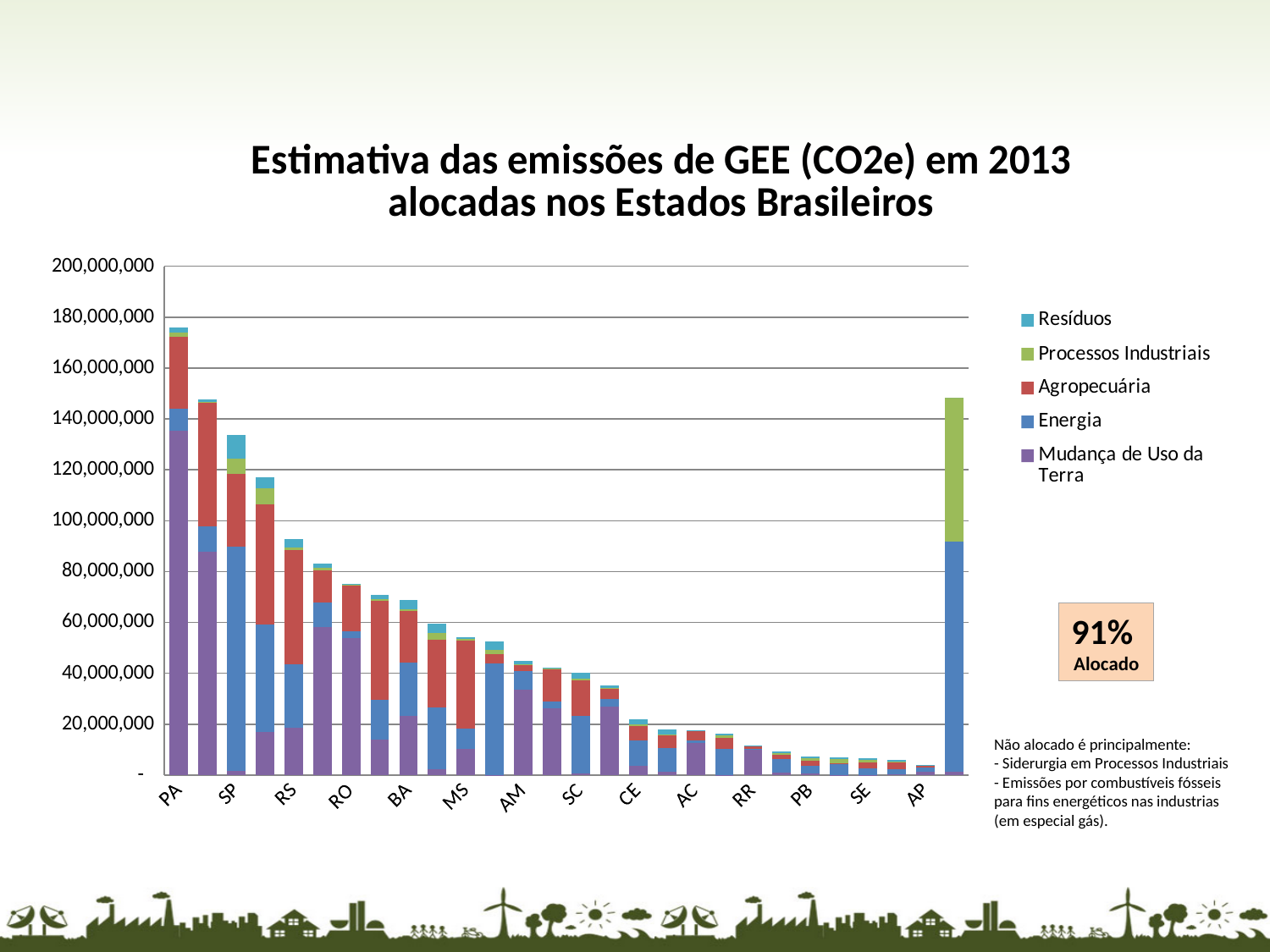
What kind of chart is shown on the slide? Stacked bar chart How many series does the legend list? 5 Is the total value for PA greater or less than 160,000,000? greater Is the total value for CE greater or less than 40,000,000? less Is the total value for SP greater or less than 120,000,000? greater Which legend entry is shown in blue? Energia Which has a larger total, BA or MS? BA Which labeled state has the highest total emissions? PA Do the total emissions of the labeled states rise or fall from left to right along the x axis? fall Which has a larger total, PA or SP? PA Which labeled state has the lowest total emissions? AP